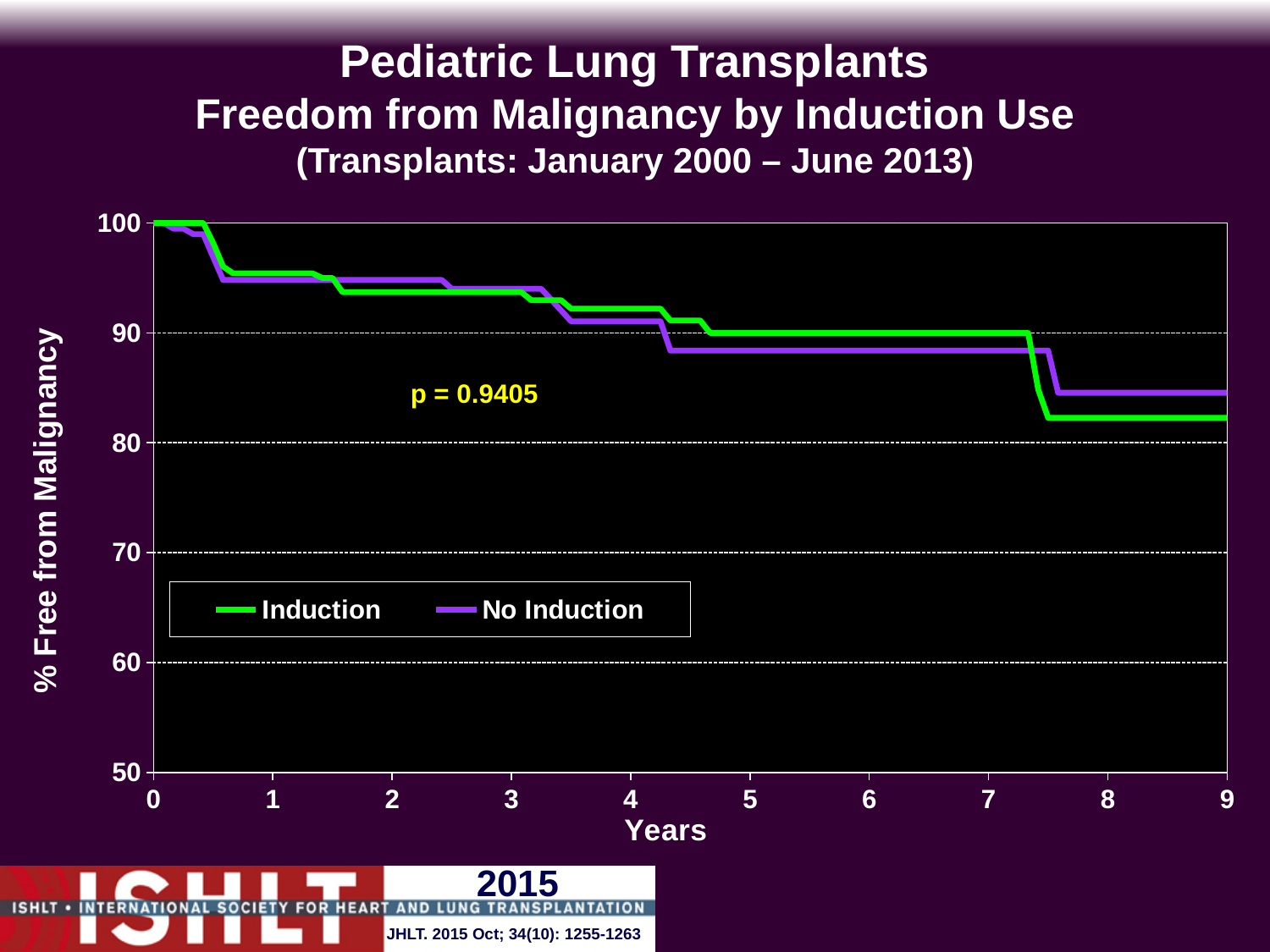
What p-value is printed on the chart? p = 0.9405 What are the two series named in the legend? Induction and No Induction Is the value for Induction at 9 years greater or less than 90? less What is the label of the x axis? Years Do the values for the Induction series rise or fall as years increase? fall Do the values for the No Induction series rise or fall as years increase? fall Is the value for Induction at 9 years greater or less than 80? greater How many series does the legend list? 2 At 9 years, which series has the higher value, Induction or No Induction? No Induction Is the value for No Induction at 8 years greater or less than 80? greater What kind of chart is shown on the slide? line chart